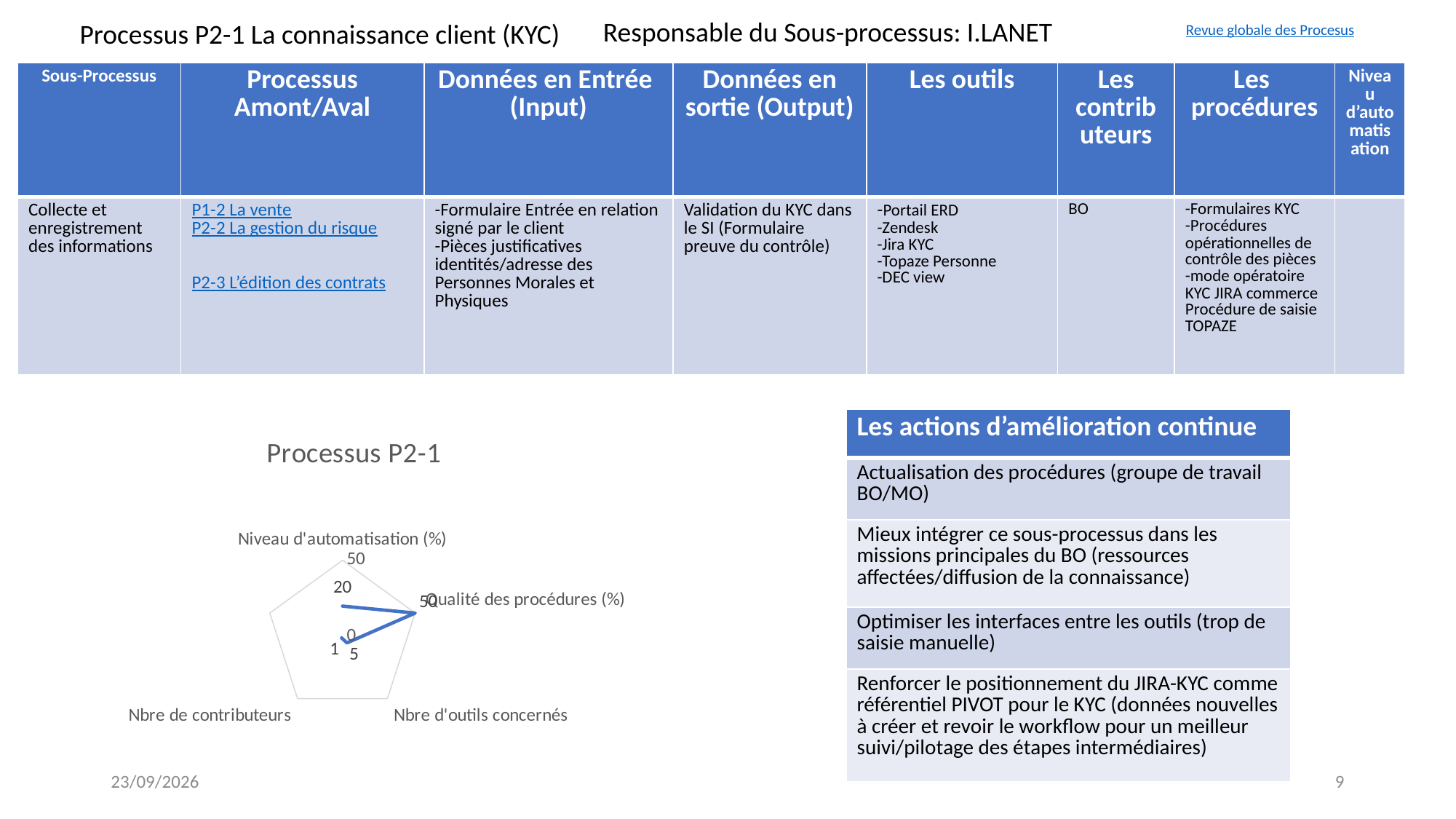
What is the value for Qualité des procédures (%) in the chart? 50 What is the value for Nbre de contributeurs in the chart? 1 What is the title of the chart on the slide? Processus P2-1 What is the value for Nbre d'outils concernés in the chart? 5 Which is larger in the chart: Qualité des procédures (%) or Niveau d'automatisation (%)? Qualité des procédures (%) What is the maximum value shown on the chart's axis scale? 50 What kind of chart is shown on the slide? Radar chart What is the value for Niveau d'automatisation (%) in the chart? 20 Which category has the highest value in the chart? Qualité des procédures (%) What is the difference between Nbre d'outils concernés and Nbre de contributeurs in the chart? 4 Which is larger in the chart: Nbre d'outils concernés or Nbre de contributeurs? Nbre d'outils concernés What is the difference between Qualité des procédures (%) and Niveau d'automatisation (%) in the chart? 30